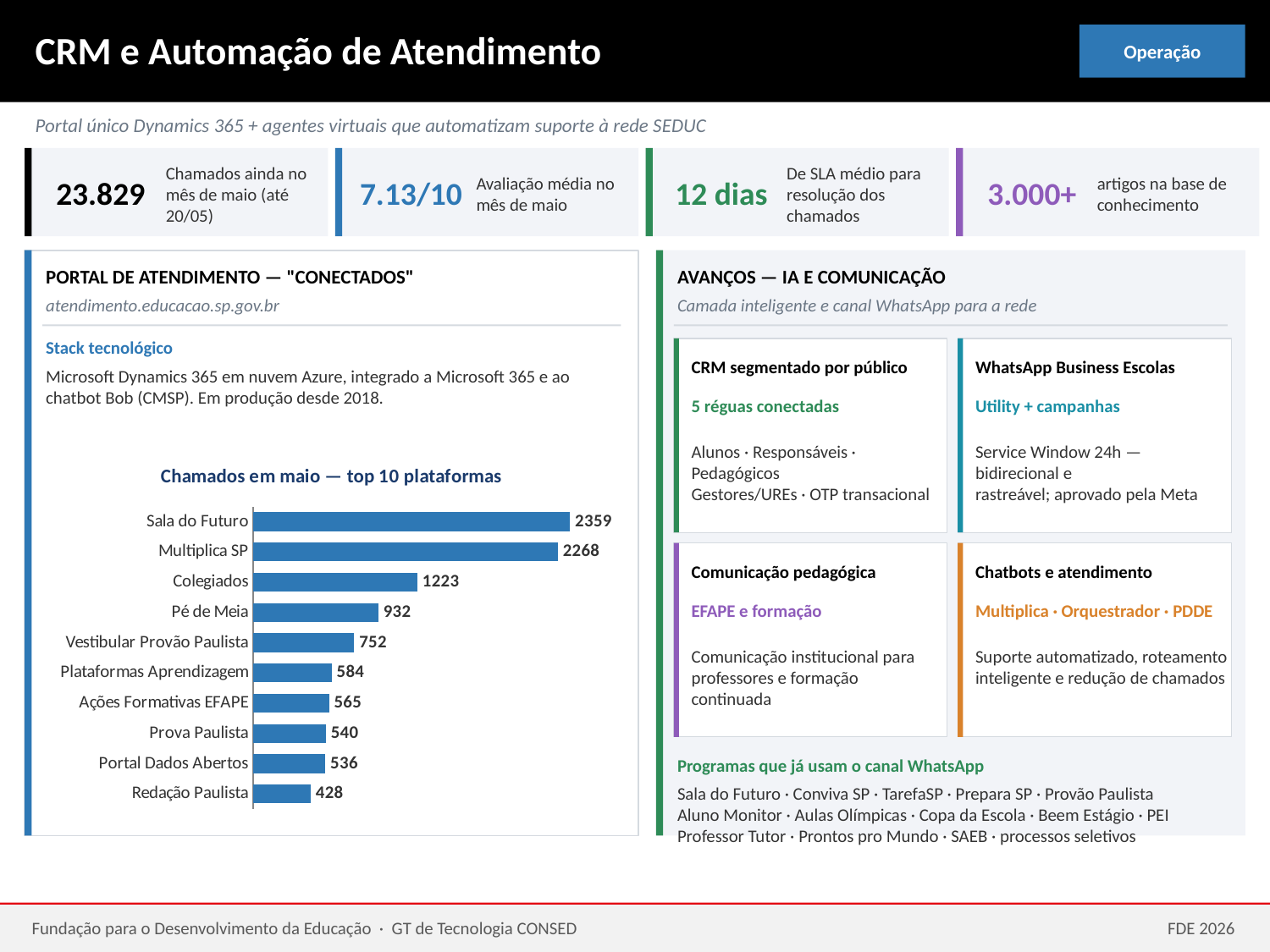
What kind of chart is 'Chamados em maio — top 10 plataformas'? Bar chart What is the difference between the values for Sala do Futuro and Multiplica SP? 91 What is the value for Portal Dados Abertos in the chart? 536 How many platforms are shown in the chart? 10 What is the value for Pé de Meia in the chart? 932 What is the value for Sala do Futuro in the chart 'Chamados em maio — top 10 plataformas'? 2359 Which platform has the highest number of chamados in the chart? Sala do Futuro Which has a larger value, Prova Paulista or Redação Paulista? Prova Paulista What is the title of the chart on the slide? Chamados em maio — top 10 plataformas Which platform has the lowest number of chamados in the chart? Redação Paulista What is the difference between the values for Colegiados and Vestibular Provão Paulista? 471 Which has a larger value, Plataformas Aprendizagem or Ações Formativas EFAPE? Plataformas Aprendizagem